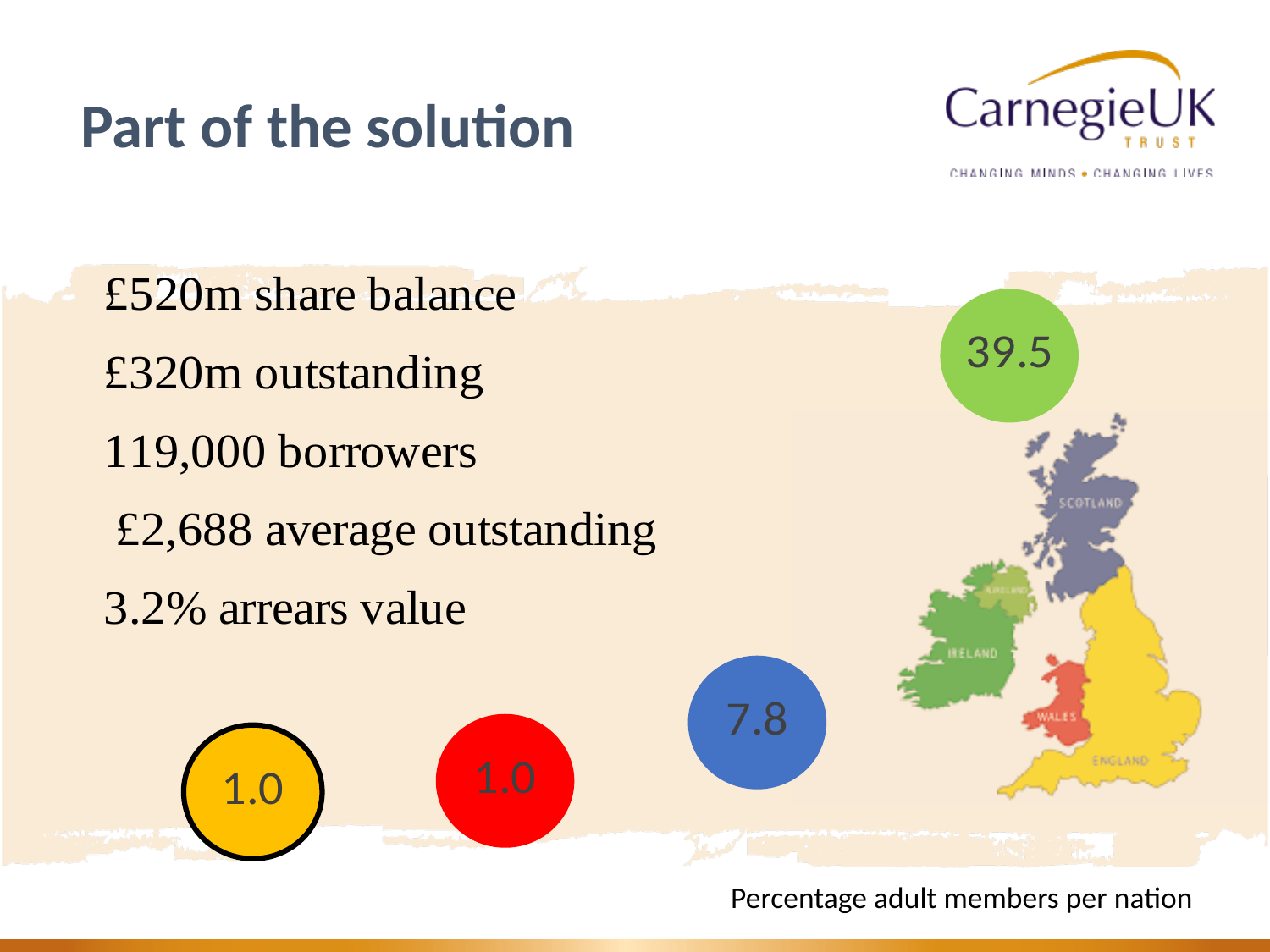
What does the caption below the map graphic say the values represent? Percentage adult members per nation What value is shown in the yellow circle on the map graphic? 1.0 What value is shown in the green circle on the map graphic? 39.5 What is the difference between the values in the green circle and the blue circle? 31.7 Do the red and yellow circles show the same value? Yes, both 1.0 What value is shown in the blue circle on the map graphic? 7.8 What is the difference between the values in the blue circle and the yellow circle? 6.8 What value is shown in the red circle on the map graphic? 1.0 Which coloured circle on the map graphic shows the highest value? green (39.5) How many value circles are shown on the map graphic? 4 Which is larger, the value in the blue circle or the value in the red circle? blue circle (7.8)